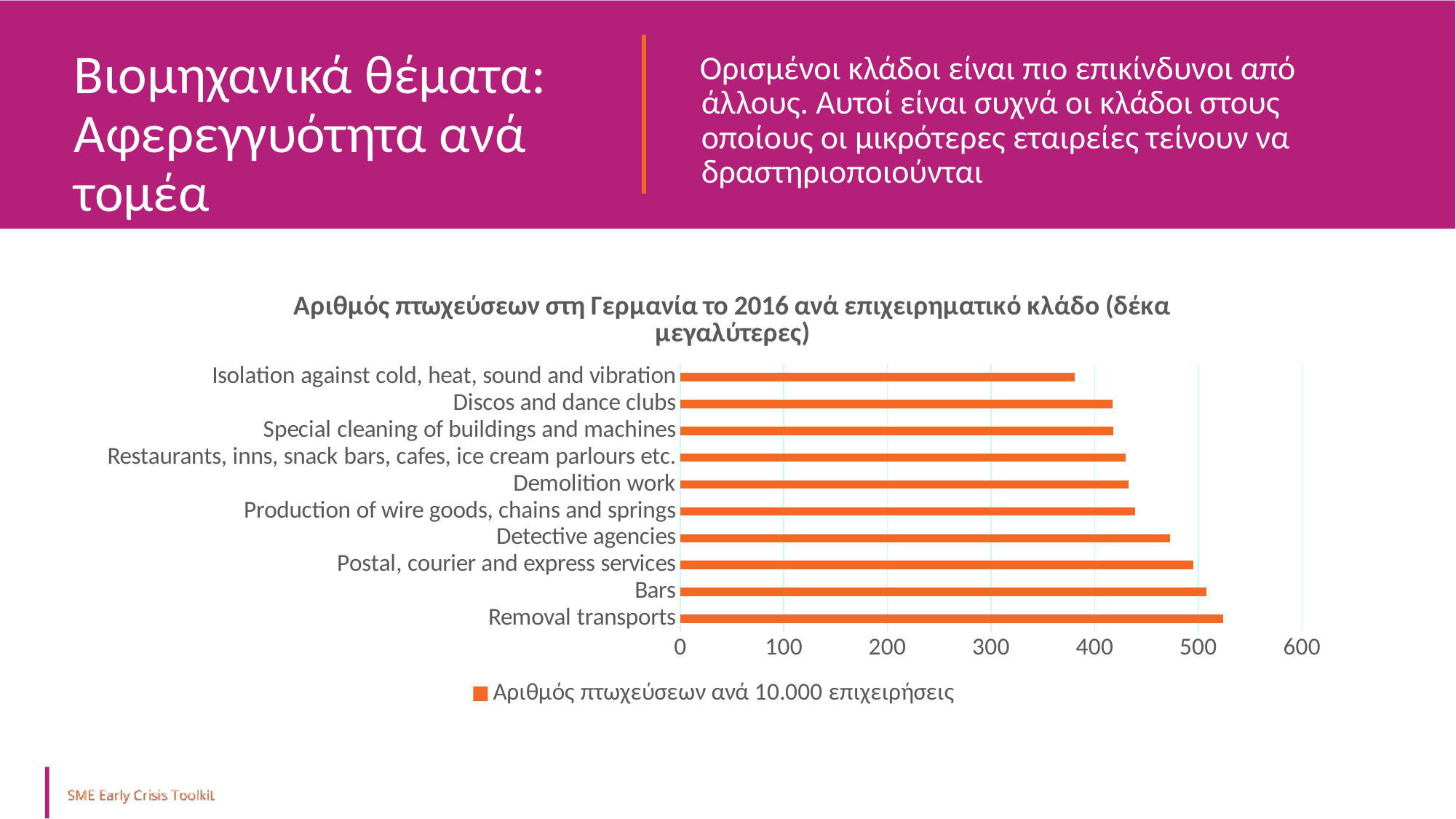
Is the value for Isolation against cold, heat, sound and vibration greater or less than 400? less Is the value for Removal transports greater or less than 500? greater What kind of chart is shown on the slide? bar chart How many series does the chart legend list? 1 Which has a higher value: Bars or Production of wire goods, chains and springs? Bars How many business sectors are listed on the chart? 10 Is the value for Detective agencies greater or less than 500? less Which sector has the lowest number of insolvencies on the chart? Isolation against cold, heat, sound and vibration Which sector has the highest number of insolvencies on the chart? Removal transports What is the legend entry shown below the chart? Αριθμός πτωχεύσεων ανά 10.000 επιχειρήσεις Which has a higher value: Detective agencies or Demolition work? Detective agencies